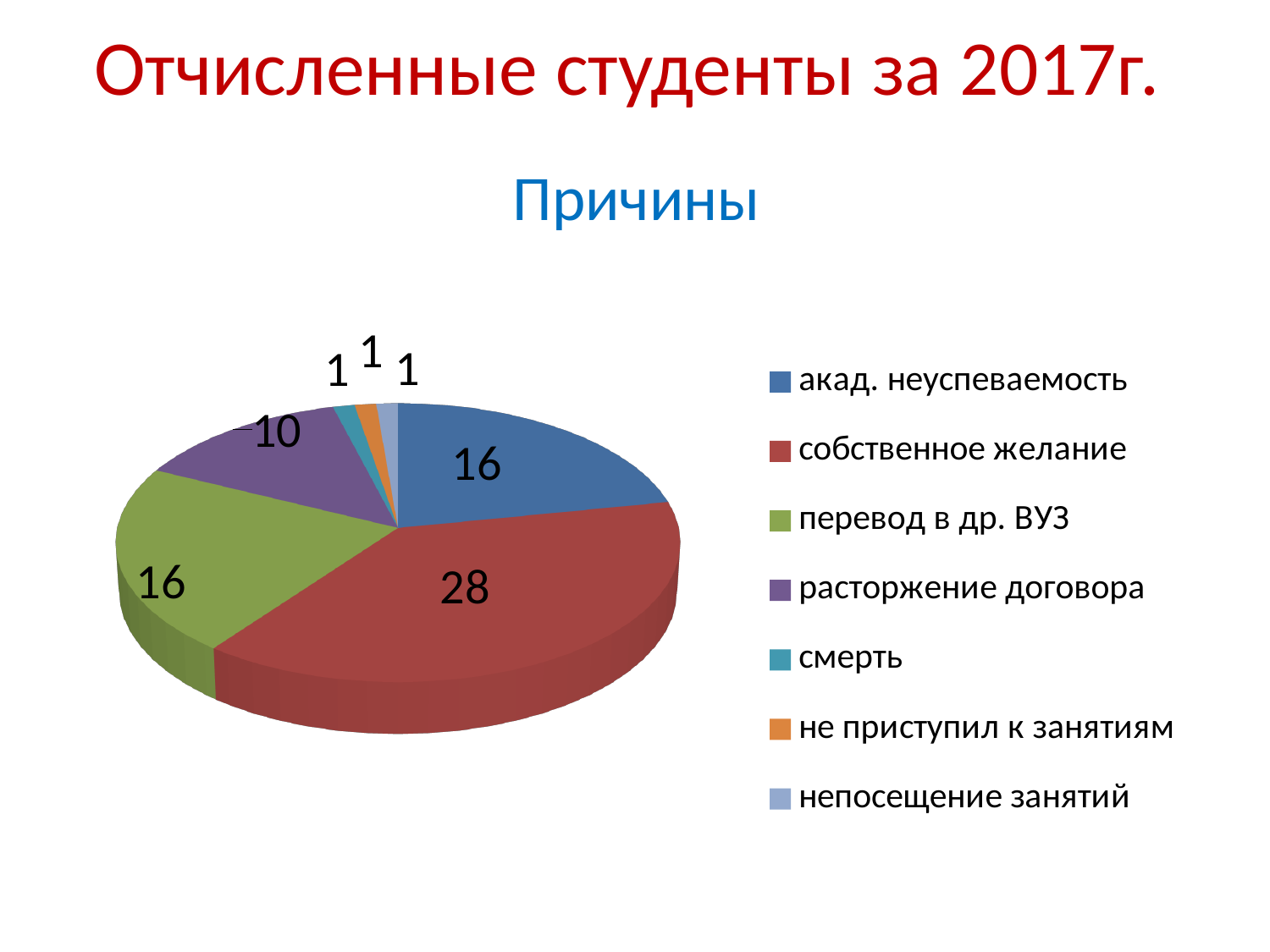
What is the title of the chart? Причины Which is larger: перевод в др. ВУЗ or расторжение договора? перевод в др. ВУЗ How many categories are shown in the pie chart? 7 What is the smallest value shown on the pie chart? 1 What is the value for расторжение договора? 10 Which category has the largest slice of the pie? собственное желание What is the value for акад. неуспеваемость? 16 What is the value for собственное желание? 28 What is the difference between the values for собственное желание and расторжение договора? 18 How many entries does the legend list? 7 What is the total of all values in the pie chart? 73 What kind of chart is shown on the slide? pie chart